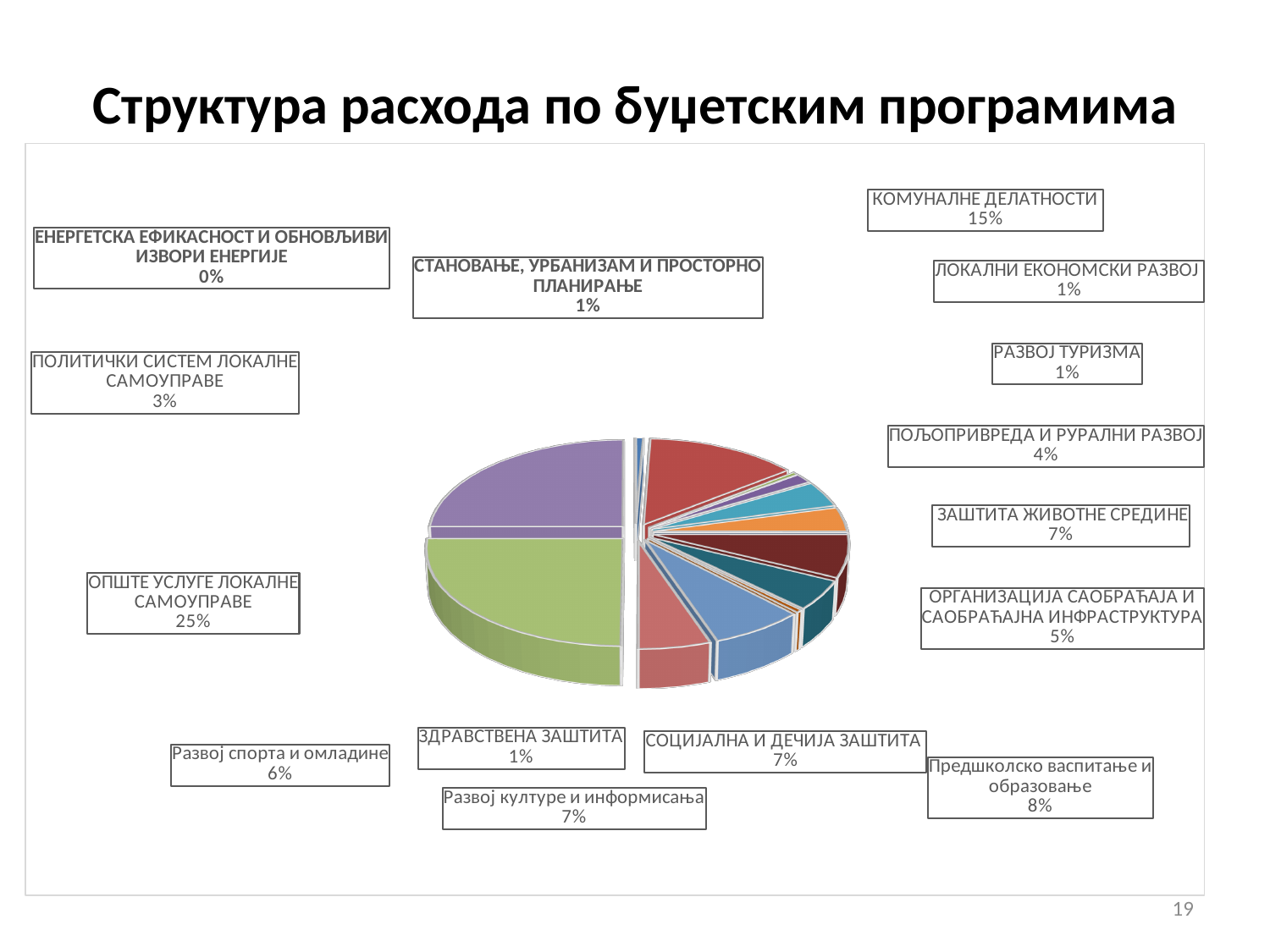
What kind of chart is shown on the slide? pie chart What is the value shown for ПОЉОПРИВРЕДА И РУРАЛНИ РАЗВОЈ? 4% What is the value shown for Развој спорта и омладине? 6% What share of expenditure goes to КОМУНАЛНЕ ДЕЛАТНОСТИ? 15% What is the difference between the shares of ОПШТЕ УСЛУГЕ ЛОКАЛНЕ САМОУПРАВЕ and КОМУНАЛНЕ ДЕЛАТНОСТИ? 10% Which has a larger share: ЗАШТИТА ЖИВОТНЕ СРЕДИНЕ or ОРГАНИЗАЦИЈА САОБРАЋАЈА И САОБРАЋАЈНА ИНФРАСТРУКТУРА? ЗАШТИТА ЖИВОТНЕ СРЕДИНЕ What is the value shown for ПОЛИТИЧКИ СИСТЕМ ЛОКАЛНЕ САМОУПРАВЕ? 3% What is the title of the slide? Структура расхода по буџетским програмима Which budget program has the smallest share of expenditure? ЕНЕРГЕТСКА ЕФИКАСНОСТ И ОБНОВЉИВИ ИЗВОРИ ЕНЕРГИЈЕ How many budget programs are labelled on the pie chart? 15 Which budget program has the largest share of expenditure? ОПШТЕ УСЛУГЕ ЛОКАЛНЕ САМОУПРАВЕ What is the value shown for Предшколско васпитање и образовање? 8%